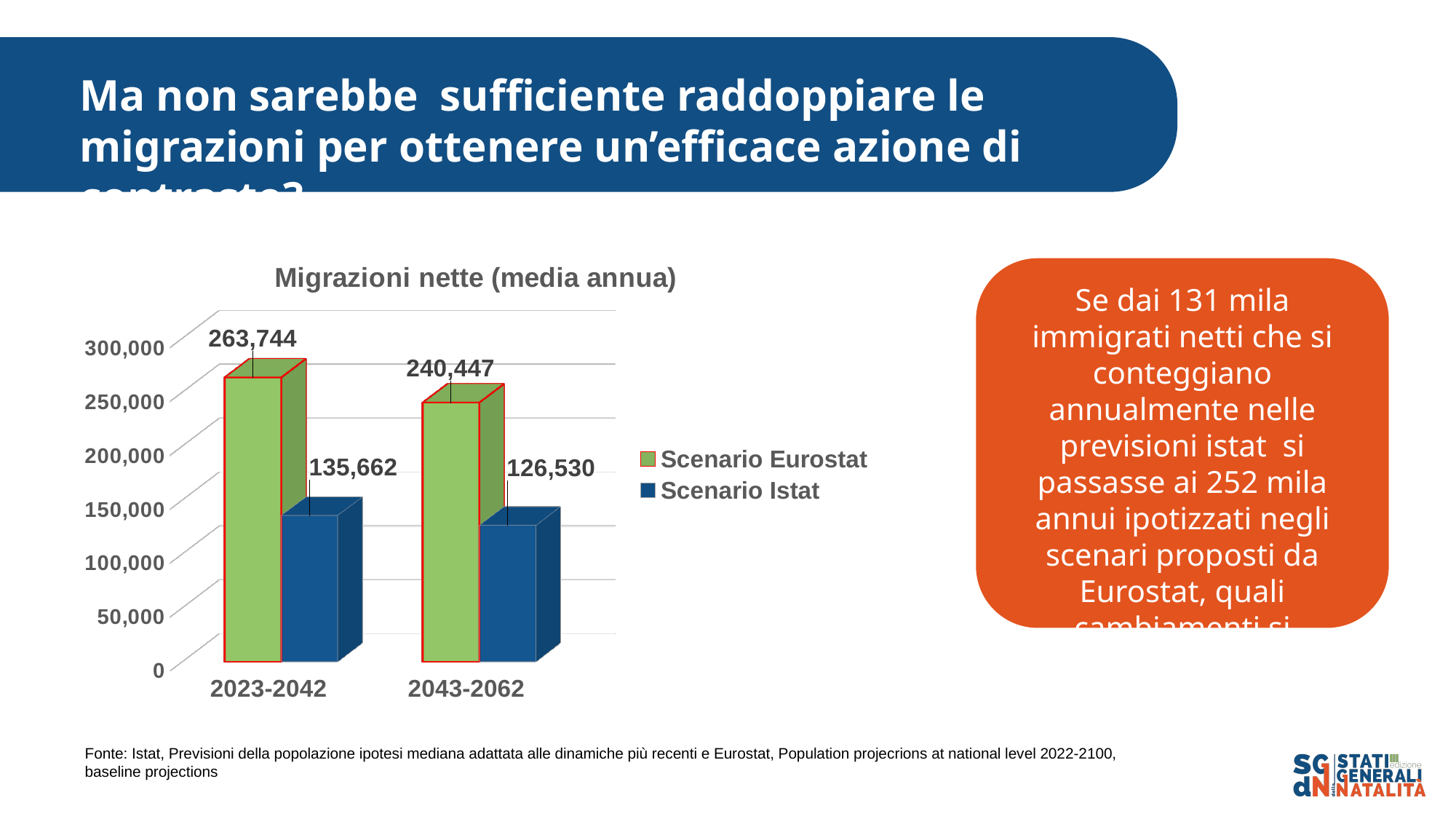
What is the value for Scenario Eurostat in 2043-2062? 240,447 What is the value for Scenario Istat in 2023-2042? 135,662 Which is larger in 2043-2062, Scenario Eurostat or Scenario Istat? Scenario Eurostat How many series does the legend list? 2 What is the difference between Scenario Eurostat and Scenario Istat in 2023-2042? 128,082 What is the difference between Scenario Eurostat in 2023-2042 and in 2043-2062? 23,297 What is the value for Scenario Istat in 2043-2062? 126,530 What kind of chart is shown on the slide? Bar chart Which bar has the lowest value in the chart? Scenario Istat, 2043-2062 Which bar has the highest value in the chart? Scenario Eurostat, 2023-2042 Do the Scenario Istat values rise or fall from 2023-2042 to 2043-2062? Fall What is the value for Scenario Eurostat in 2023-2042? 263,744